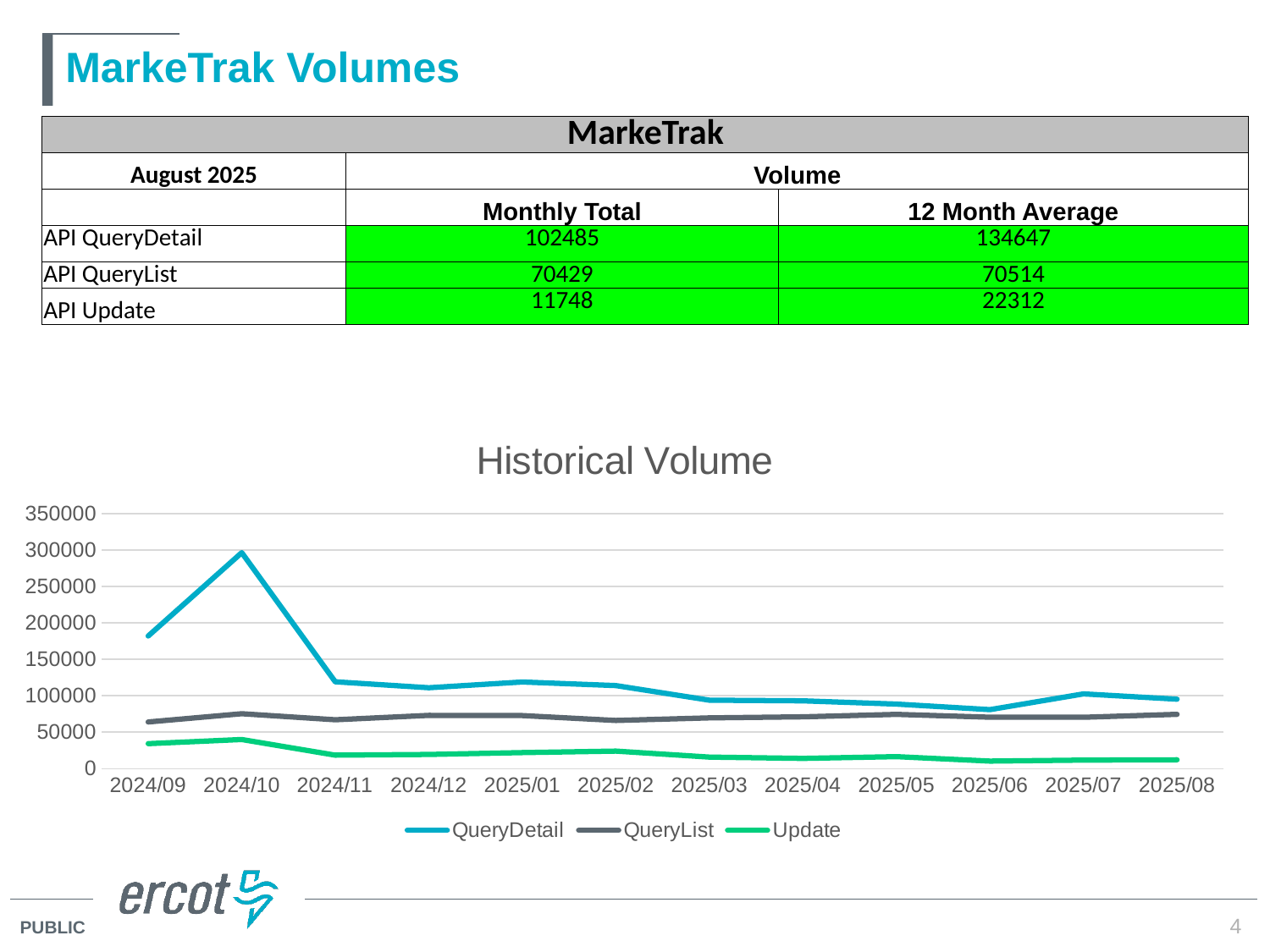
In the Historical Volume chart, is the QueryDetail value for 2024/10 greater or less than 250000? greater How many series does the legend of the Historical Volume chart list? 3 How many months are shown on the x axis of the Historical Volume chart? 12 In the Historical Volume chart, in which month does the QueryDetail series reach its highest value? 2024/10 In the Historical Volume chart, which series is higher at 2024/10, QueryDetail or QueryList? QueryDetail What kind of chart is the Historical Volume chart? line chart In the Historical Volume chart, does the QueryDetail series rise or fall from 2024/10 to 2024/11? fall What are the three series named in the legend of the Historical Volume chart? QueryDetail, QueryList, Update In the Historical Volume chart, is the QueryList value for 2025/08 greater or less than 100000? less In the Historical Volume chart, is the QueryDetail value for 2024/09 greater or less than 150000? greater In the Historical Volume chart, which series has the lowest values across all months? Update